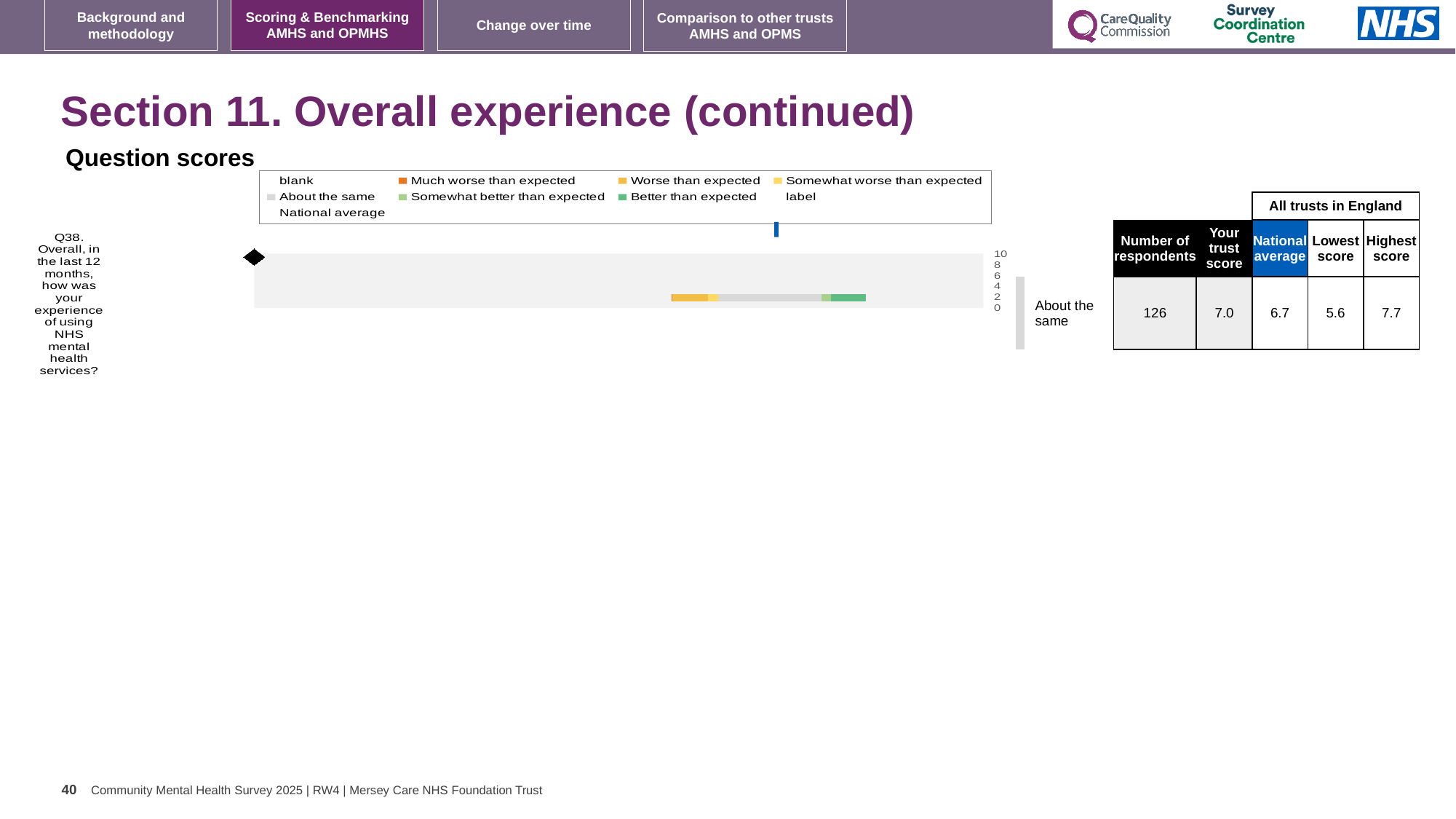
What kind of chart is shown under the heading 'Question scores'? bar chart What is the 'Your trust score' value for Q38? 7.0 What is the difference between the trust score and the national average for Q38? 0.3 What rating category is shown next to the bar for Q38? About the same What is the lowest score among all trusts in England for Q38? 5.6 For Q38, which is larger: the trust score or the national average? the trust score Which question number is plotted in the 'Question scores' chart? Q38 How many respondents answered Q38? 126 What is the national average score for Q38? 6.7 What is the difference between the highest score and the lowest score for Q38? 2.1 What is the highest score among all trusts in England for Q38? 7.7 How many questions are plotted in the 'Question scores' chart? 1